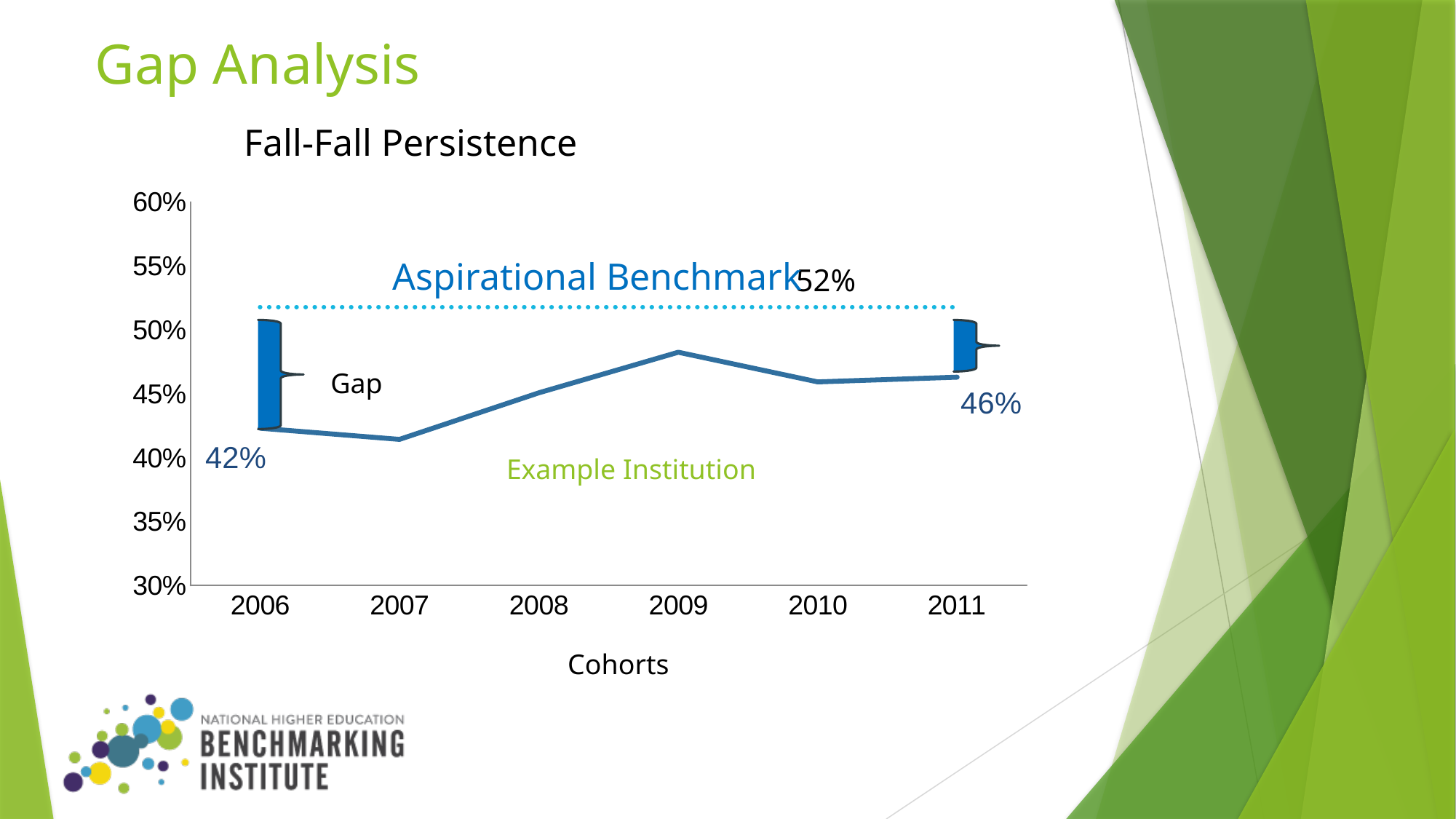
How many cohorts are plotted on the x axis? 6 What is the Fall-Fall Persistence value for the 2006 cohort? 42% What is the Fall-Fall Persistence value for the 2011 cohort? 46% What is the title of the x axis? Cohorts What is the gap between the Aspirational Benchmark and the 2011 cohort value? 6 percentage points What kind of chart is shown on the slide? Line chart Which cohort has the highest Fall-Fall Persistence for the Example Institution? 2009 By how many percentage points did the Example Institution's persistence rise from the 2006 cohort to the 2011 cohort? 4 percentage points Is the value for the 2009 cohort greater or less than 45%? greater What value is shown for the Aspirational Benchmark? 52% Is the value for the 2007 cohort greater or less than 45%? less Which cohort has the larger persistence value, 2009 or 2010? 2009